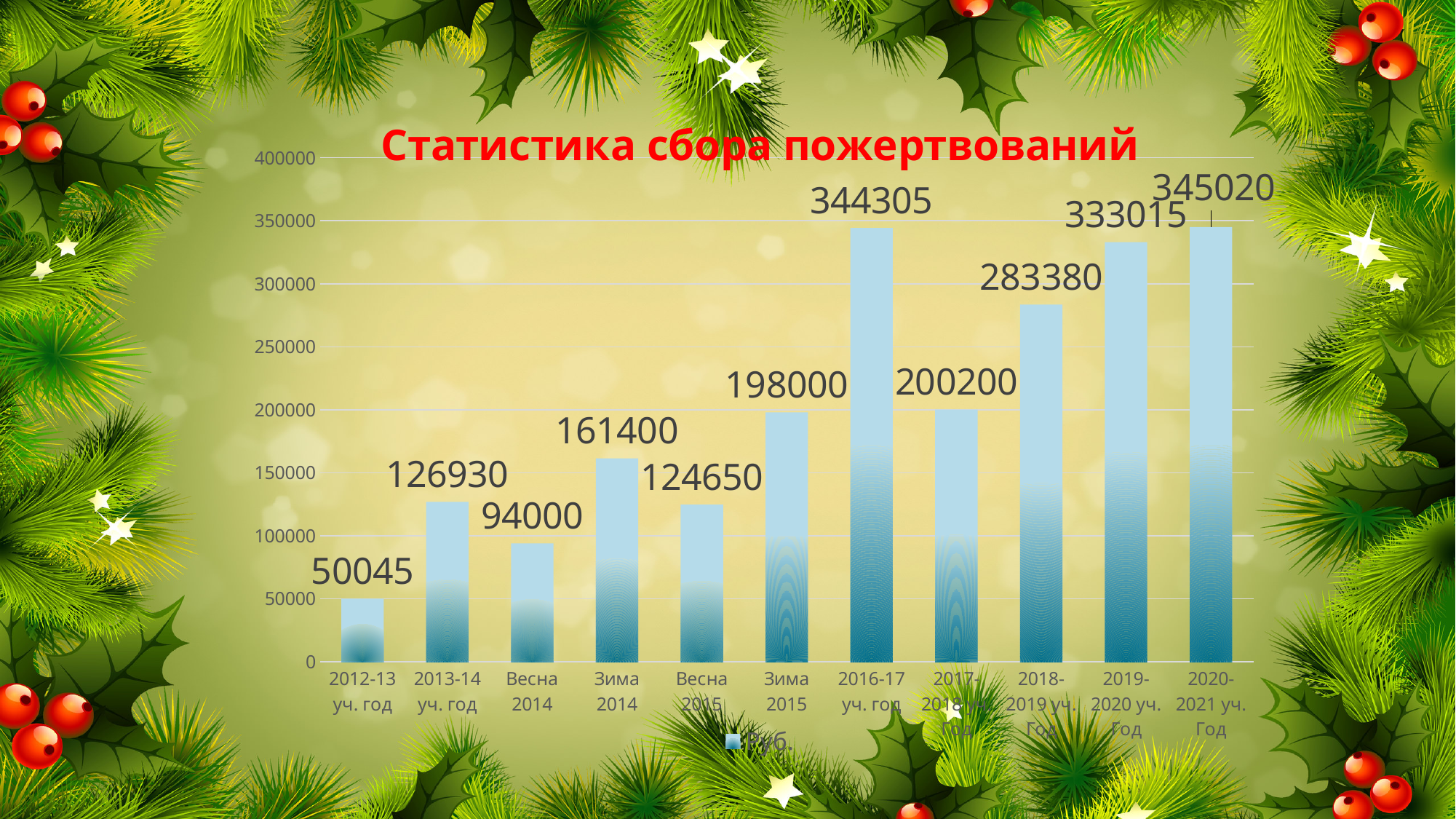
What is the value for 2012-13 уч. год? 50045 Which is larger, the value for Зима 2014 or the value for Весна 2015? Зима 2014 What type of chart is shown on the slide? Bar chart How many categories (bars) are shown in the chart? 11 What is the difference between the values for 2020-2021 уч. год and 2016-17 уч. год? 715 Is the value for 2019-2020 уч. год greater or less than 300000? greater Which category has the lowest value? 2012-13 уч. год What is the title of the chart? Статистика сбора пожертвований What is the value for Зима 2015? 198000 What is the difference between the values for 2018-2019 уч. год and 2017-2018 уч. год? 83180 Which category has the highest value? 2020-2021 уч. год What is the value for 2018-2019 уч. год? 283380